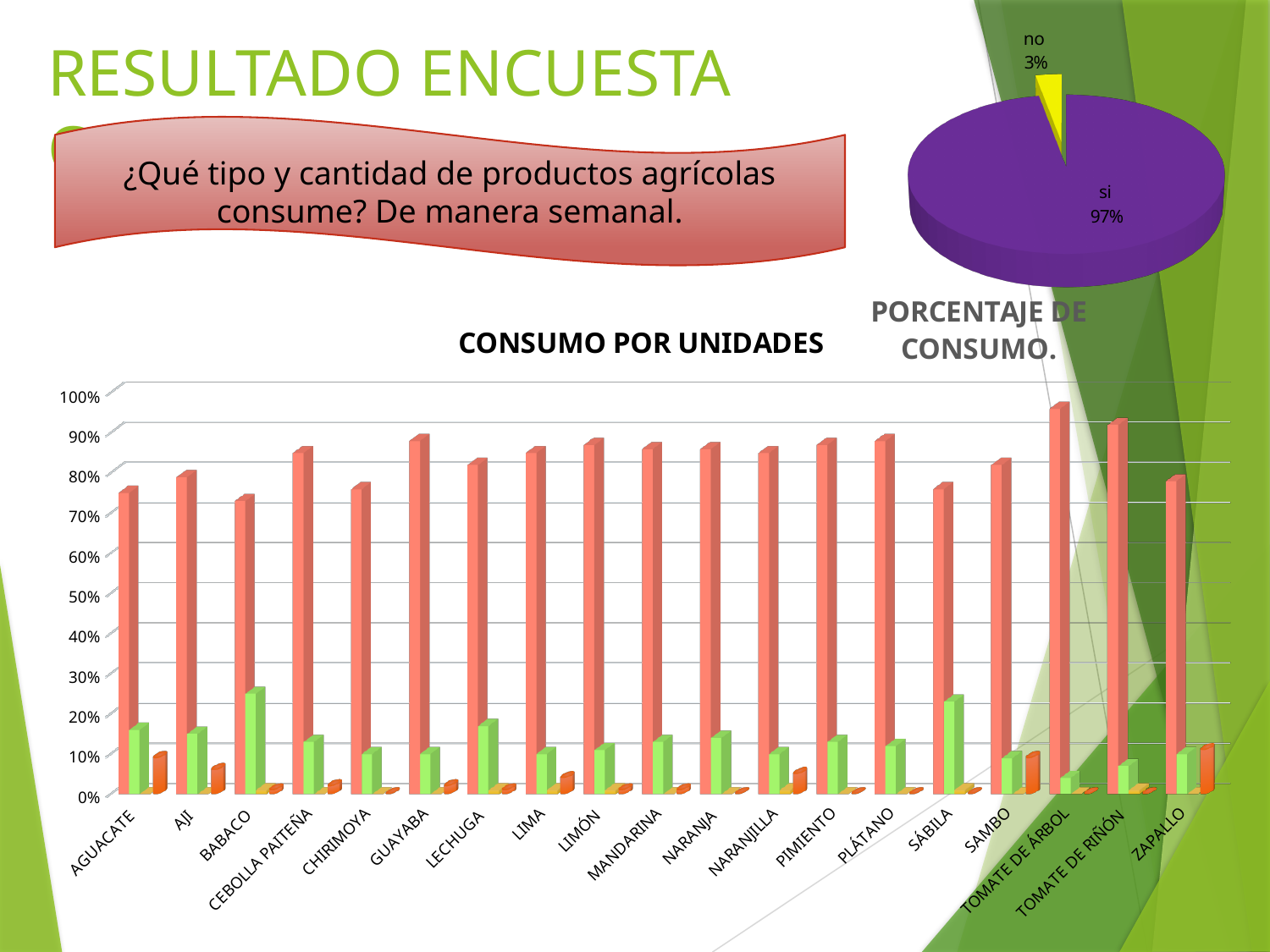
In the CONSUMO POR UNIDADES chart, is the tallest (red) bar for BABACO greater or less than 80%? less In the CONSUMO POR UNIDADES chart, is the tallest (red) bar for TOMATE DE ÁRBOL greater or less than 90%? greater In the CONSUMO POR UNIDADES chart, how many product categories are shown on the x axis? 19 In the CONSUMO POR UNIDADES chart, is the green bar for BABACO greater or less than 20%? greater What kind of chart is the CONSUMO POR UNIDADES chart? Bar chart In the PORCENTAJE DE CONSUMO pie chart, how many slices are there? 2 What kind of chart is the PORCENTAJE DE CONSUMO chart? Pie chart In the PORCENTAJE DE CONSUMO pie chart, what percentage is shown for "no"? 3% In the PORCENTAJE DE CONSUMO pie chart, which slice is the largest? si In the PORCENTAJE DE CONSUMO pie chart, by how many percentage points does "si" exceed "no"? 94 percentage points In the PORCENTAJE DE CONSUMO pie chart, what percentage is shown for "si"? 97%